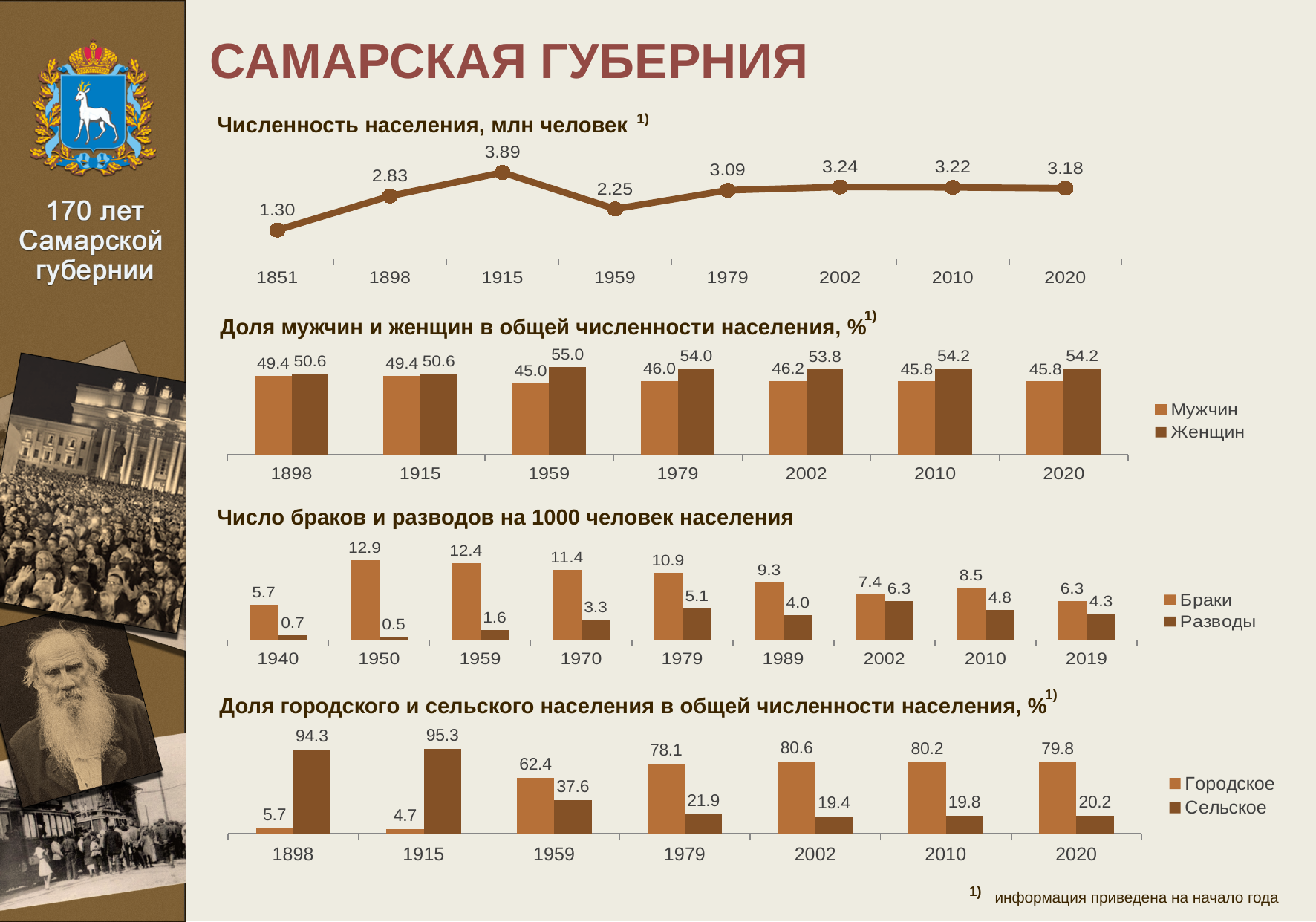
In the chart 'Численность населения, млн человек', how many data points are plotted? 8 In the chart 'Число браков и разводов на 1000 человек населения', which year has the highest value for Браки? 1950 How many series does the legend of the chart 'Число браков и разводов на 1000 человек населения' list? 2 In the chart 'Численность населения, млн человек', what is the value for 1915? 3.89 What kind of chart is 'Численность населения, млн человек'? line chart In the chart 'Доля городского и сельского населения в общей численности населения, %', what is the difference between Городское and Сельское in 1959? 24.8 In the chart 'Доля мужчин и женщин в общей численности населения, %', what is the value for Женщин in 1959? 55.0 In the chart 'Численность населения, млн человек', which year has the lowest value? 1851 In the chart 'Доля мужчин и женщин в общей численности населения, %', what is the difference between Женщин and Мужчин in 2020? 8.4 In the chart 'Доля городского и сельского населения в общей численности населения, %', what is the value for Сельское in 1915? 95.3 In the chart 'Число браков и разводов на 1000 человек населения', which is larger in 2002: Браки or Разводы? Браки In the chart 'Число браков и разводов на 1000 человек населения', what is the value for Разводы in 1970? 3.3